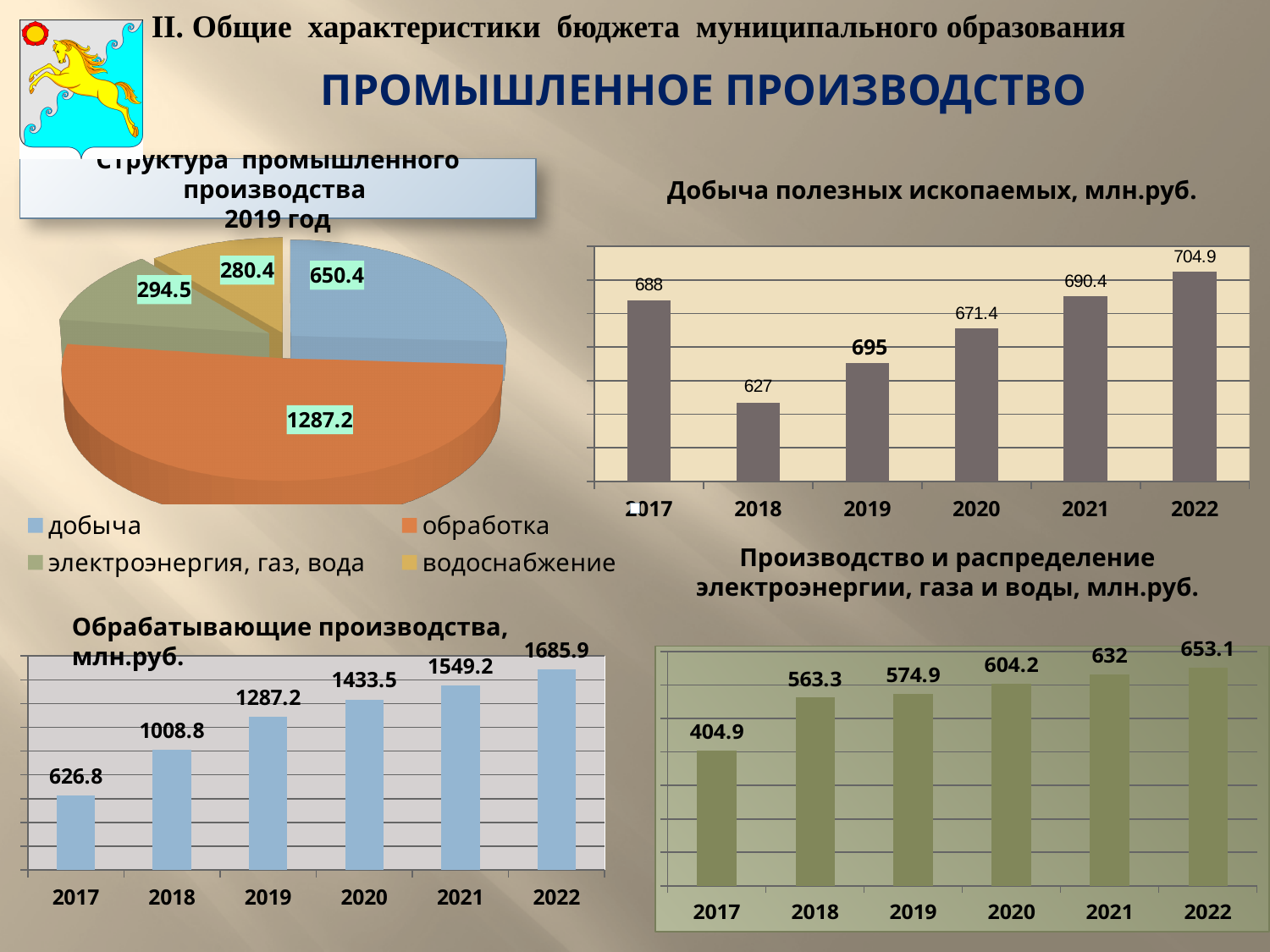
What type of chart is 'Структура промышленного производства 2019 год'? pie chart In the chart 'Производство и распределение электроэнергии, газа и воды, млн.руб.', how many years are shown? 6 In the chart 'Производство и распределение электроэнергии, газа и воды, млн.руб.', what is the difference between the 2022 and 2021 values? 21.1 In the chart 'Производство и распределение электроэнергии, газа и воды, млн.руб.', what is the value for 2017? 404.9 In the chart 'Обрабатывающие производства, млн.руб.', do the values rise or fall from 2017 to 2022? rise In the chart 'Обрабатывающие производства, млн.руб.', which year has the highest value? 2022 In the chart 'Добыча полезных ископаемых, млн.руб.', what is the difference between the 2022 and 2018 values? 77.9 In the chart 'Обрабатывающие производства, млн.руб.', what is the value for 2019? 1287.2 In the pie chart 'Структура промышленного производства 2019 год', what is the value for обработка? 1287.2 In the chart 'Добыча полезных ископаемых, млн.руб.', which year has the lowest value? 2018 In the chart 'Добыча полезных ископаемых, млн.руб.', what is the value for 2022? 704.9 In the pie chart 'Структура промышленного производства 2019 год', which of добыча or водоснабжение has the larger value? добыча